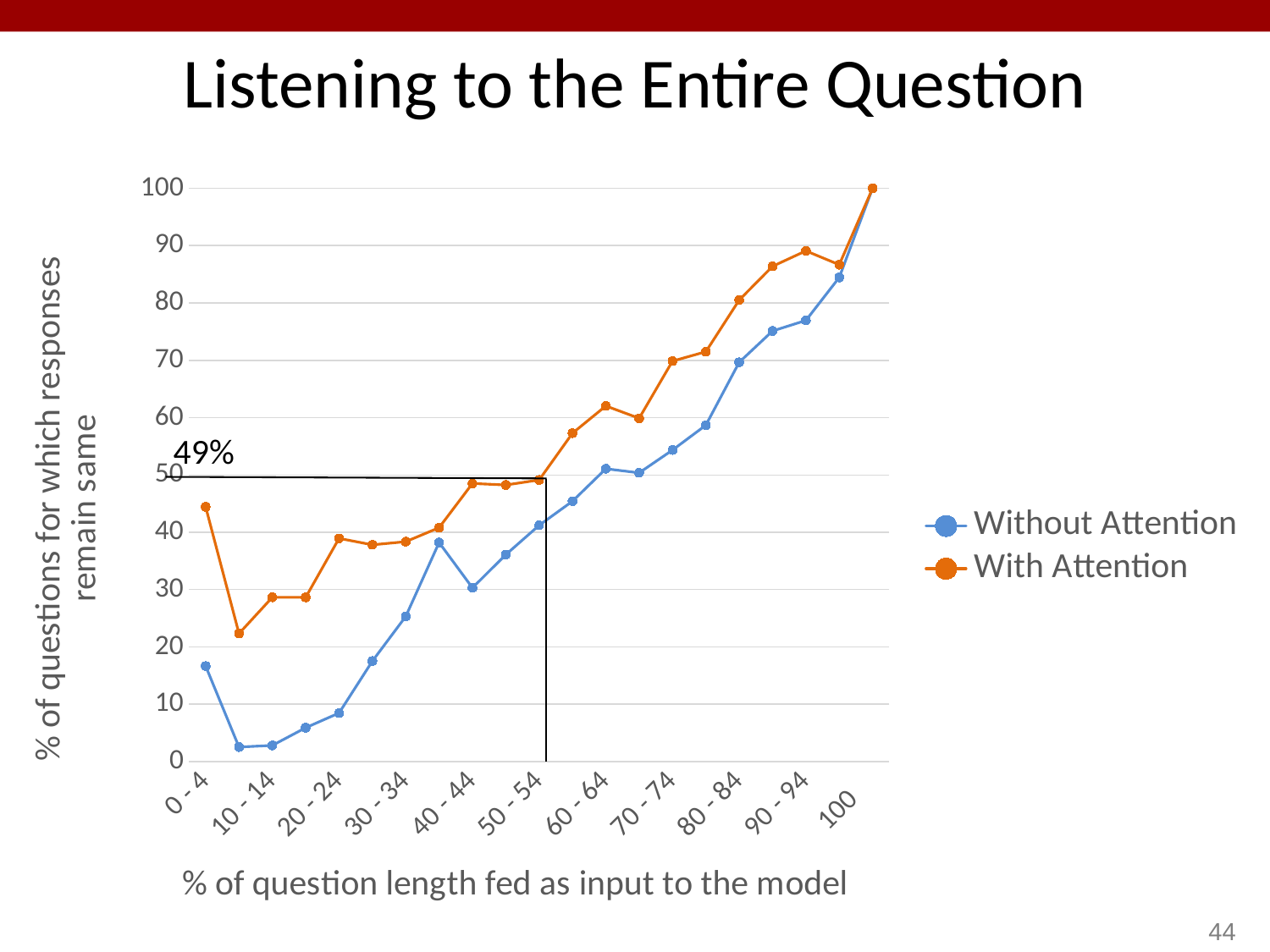
What are the two series named in the legend? Without Attention and With Attention Is the value for With Attention at 0 - 4 greater or less than 40? greater At which x-axis category does the With Attention series reach its highest value? 100 Is the value for Without Attention at 10 - 14 greater or less than 10? less What is the value of the With Attention series at the 100 category? 100 Do the Without Attention values rise or fall from 50 - 54 to 100? rise What kind of chart is shown on the slide? line chart How many series does the legend list? 2 Is the value for Without Attention at 80 - 84 greater or less than 50? greater What value is annotated for the With Attention series at the 50 - 54 category? 49% At the 20 - 24 category, which series has the higher value? With Attention What is the title of the x axis? % of question length fed as input to the model